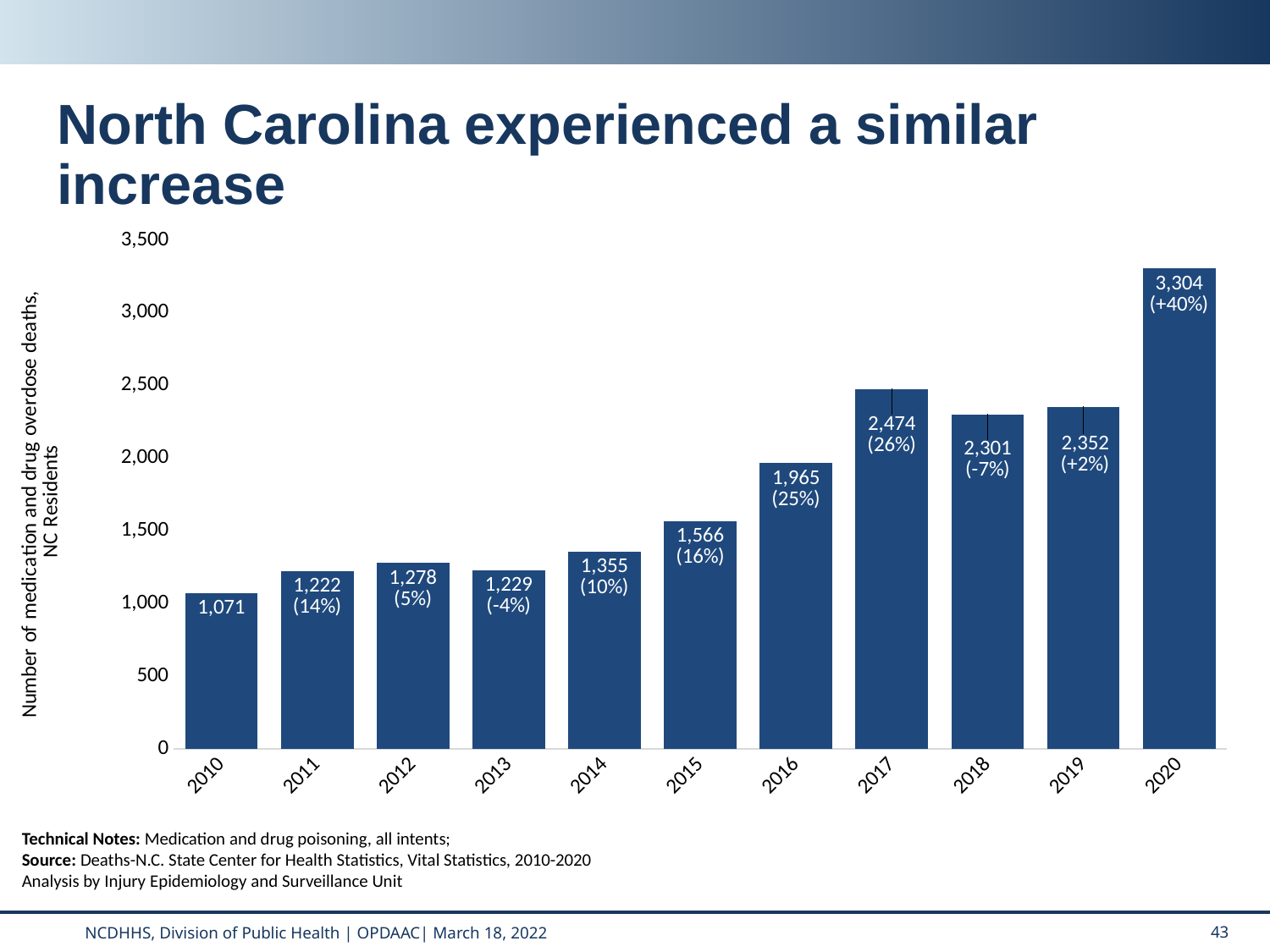
What is the number of medication and drug overdose deaths for 2016? 1,965 Is the value for 2015 greater or less than 1,500? greater What is the number of medication and drug overdose deaths for 2010? 1,071 How many years are shown on the x axis? 11 Which year had more deaths, 2017 or 2018? 2017 What kind of chart is shown on the slide? Bar chart Which year has the lowest number of medication and drug overdose deaths? 2010 What is the difference in deaths between 2020 and 2019? 952 Do the values generally rise or fall from 2010 to 2020? Rise What is the number of medication and drug overdose deaths for 2020? 3,304 Which year has the highest number of medication and drug overdose deaths? 2020 What percentage change is shown for 2020? +40%